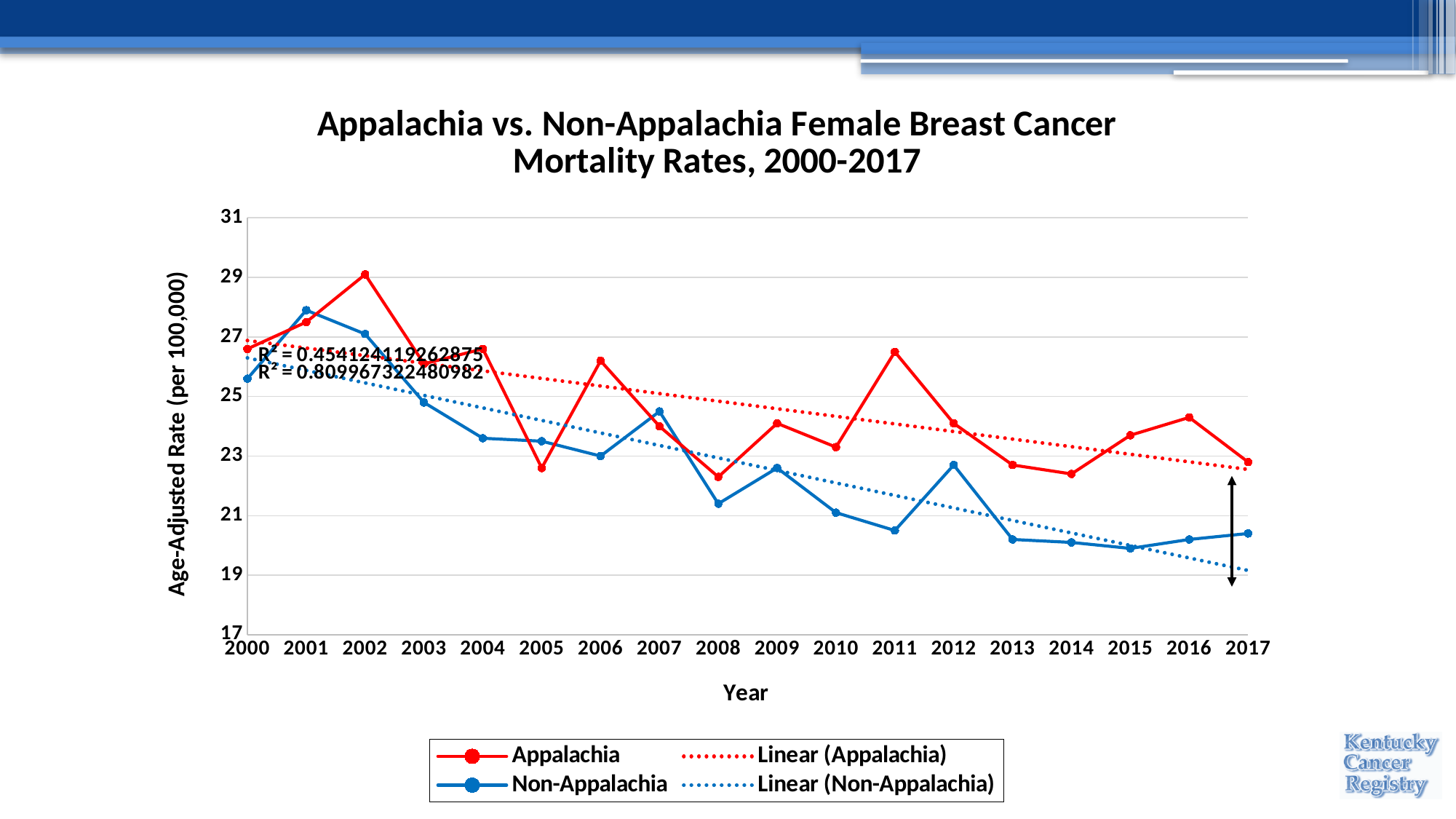
Is the Appalachia value for 2011 greater or less than 25? greater Do the Non-Appalachia mortality rates generally rise or fall from 2000 to 2017? Fall What is the title of the chart? Appalachia vs. Non-Appalachia Female Breast Cancer Mortality Rates, 2000-2017 Do the Appalachia mortality rates generally rise or fall from 2000 to 2017? Fall In which year is the Appalachia mortality rate highest? 2002 Is the Non-Appalachia value for 2008 greater or less than 23? less What kind of chart is shown on the slide? Line chart How many years are plotted along the x axis? 18 In which year is the Non-Appalachia mortality rate highest? 2001 How many entries does the legend list? 4 In 2017, which series has the higher mortality rate, Appalachia or Non-Appalachia? Appalachia In 2005, which series has the higher mortality rate, Appalachia or Non-Appalachia? Non-Appalachia